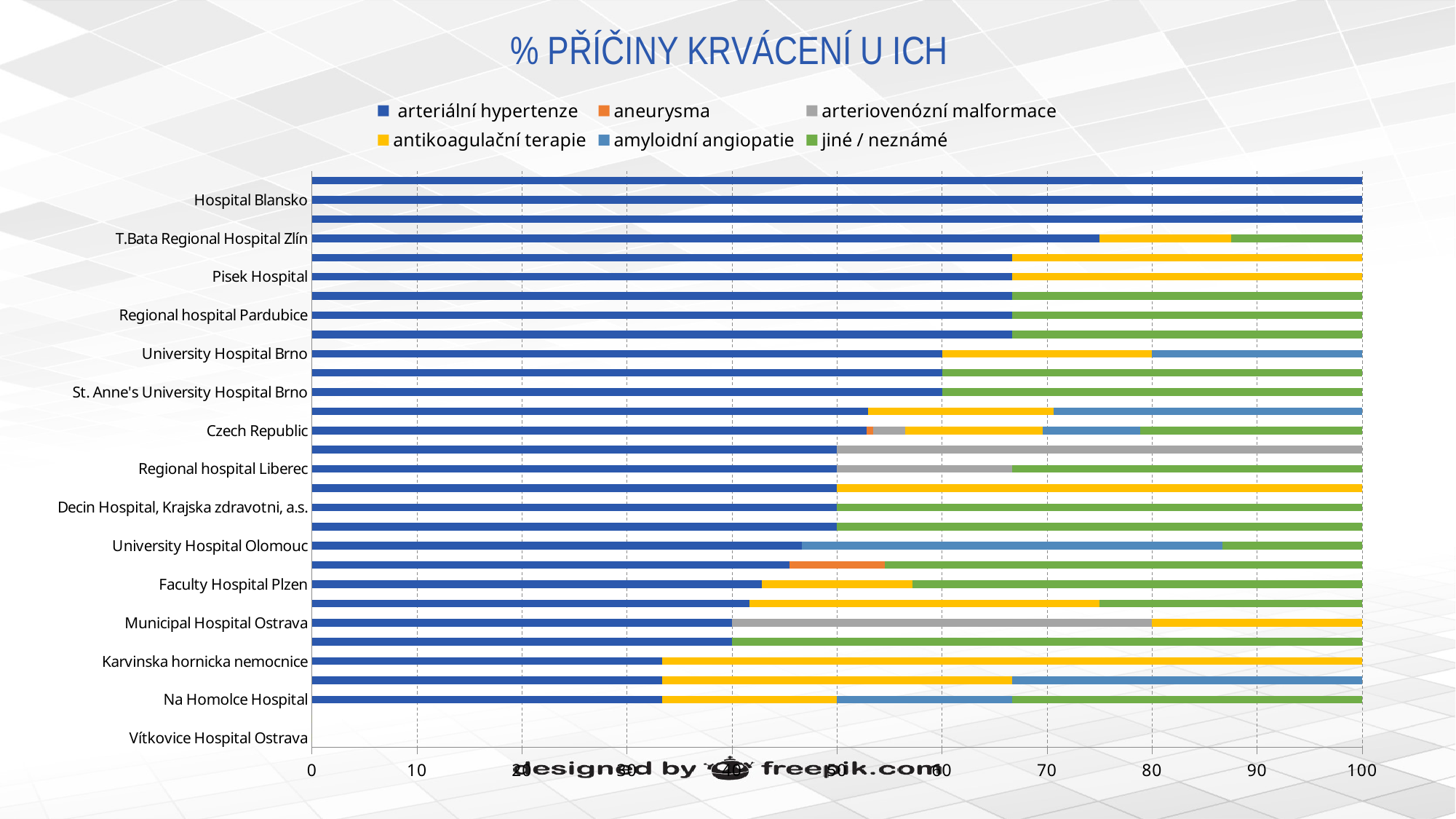
Which has a larger 'arteriální hypertenze' value, Hospital Blansko or Na Homolce Hospital? Hospital Blansko Which colour represents the series 'aneurysma' in the legend? orange Is the value of 'arteriální hypertenze' for T.Bata Regional Hospital Zlín greater or less than 70? greater What is the title of the chart? % PŘÍČINY KRVÁCENÍ U ICH Is the value of 'arteriální hypertenze' for Hospital Blansko greater or less than 90? greater What kind of chart is shown on the slide? stacked bar chart Which has a larger 'arteriální hypertenze' value, Faculty Hospital Plzen or University Hospital Brno? University Hospital Brno Which has a larger 'arteriální hypertenze' value, Pisek Hospital or Karvinska hornicka nemocnice? Pisek Hospital Is the value of 'arteriální hypertenze' for Karvinska hornicka nemocnice greater or less than 40? less How many series does the legend list? 6